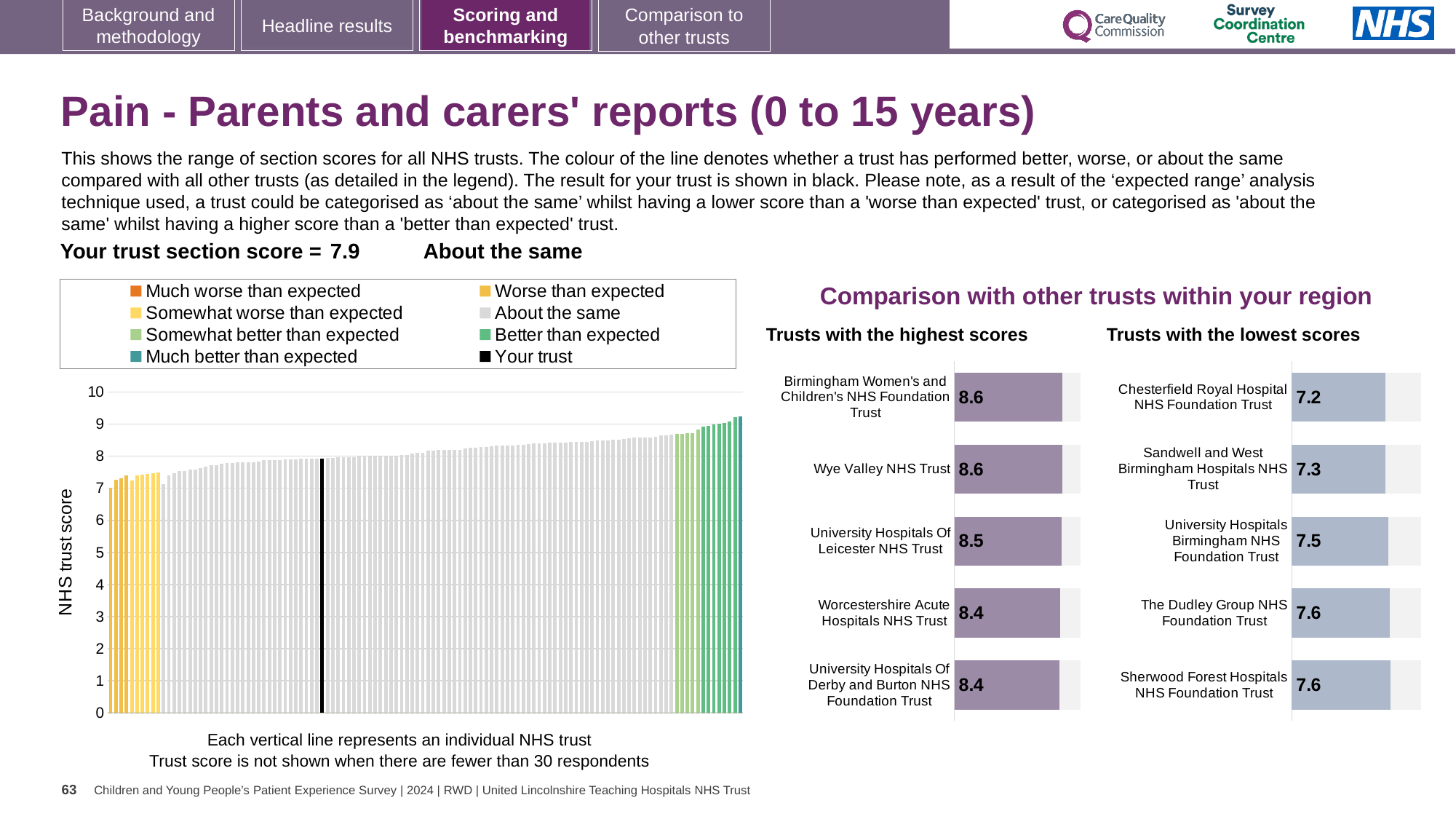
In the chart on the left, do the trust scores rise or fall from left to right? rise In the 'Trusts with the lowest scores' chart, which trust has the lowest score? Chesterfield Royal Hospital NHS Foundation Trust In the 'Trusts with the lowest scores' chart, what is the difference between the scores of The Dudley Group NHS Foundation Trust and Chesterfield Royal Hospital NHS Foundation Trust? 0.4 In the chart on the left, what is the label on the vertical axis? NHS trust score How many entries does the legend above the chart on the left list? 8 In the 'Trusts with the highest scores' chart, how many trusts are shown? 5 In the 'Trusts with the highest scores' chart, what is the score for Wye Valley NHS Trust? 8.6 What kind of chart is the chart on the left showing NHS trust scores? bar chart In the 'Trusts with the highest scores' chart, what is the difference between the scores of Wye Valley NHS Trust and Worcestershire Acute Hospitals NHS Trust? 0.2 In the 'Trusts with the lowest scores' chart, which has the larger score: Sandwell and West Birmingham Hospitals NHS Trust or University Hospitals Birmingham NHS Foundation Trust? University Hospitals Birmingham NHS Foundation Trust In the chart on the left, is the value of the highest (rightmost) bar greater or less than 9? greater In the chart on the left, what is the section score for your trust (the black bar)? 7.9